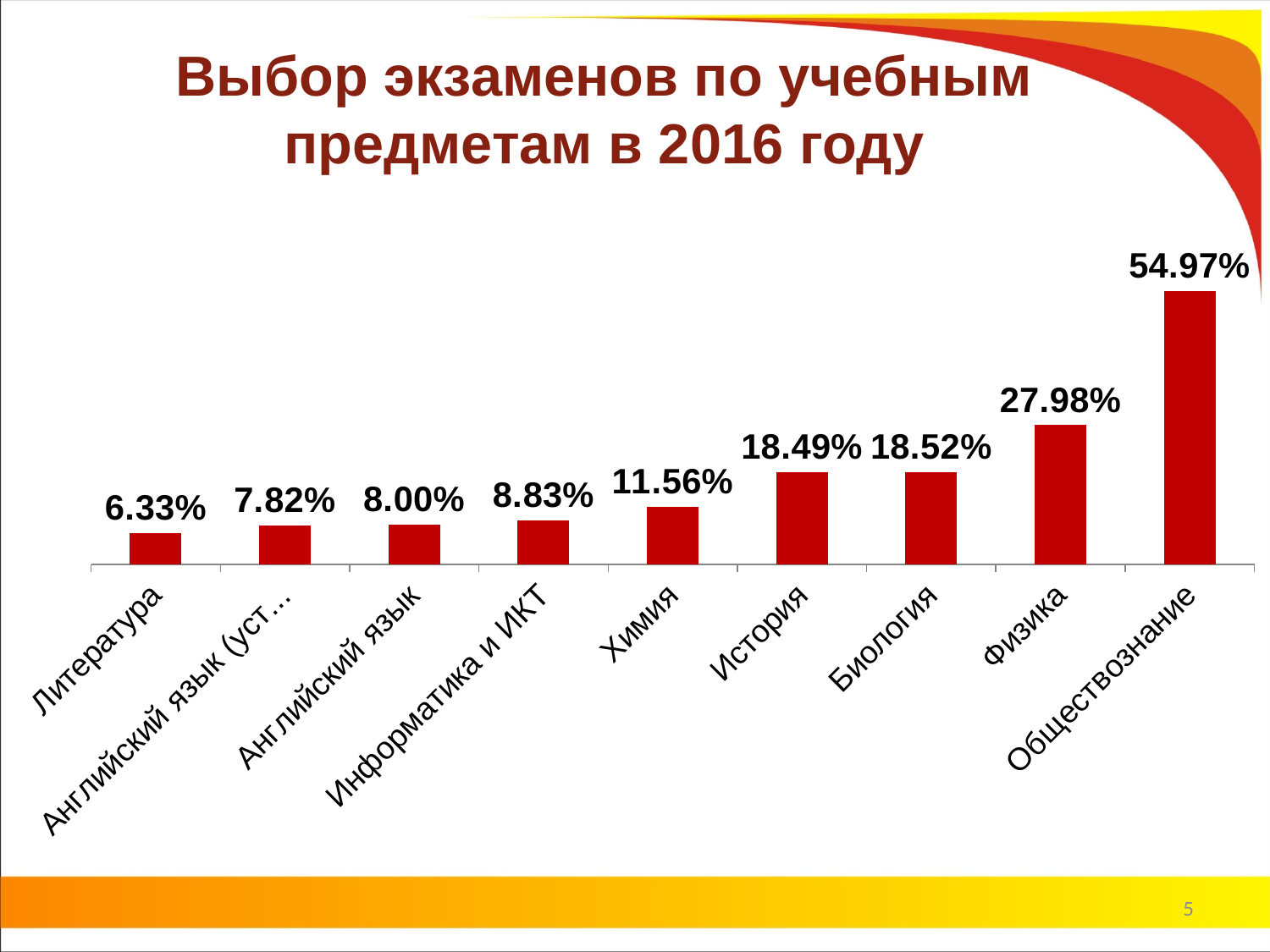
What is the value for Химия? 11.56% What is the value for Литература? 6.33% Which subject has the highest value? Обществознание How many subjects are shown in the chart? 9 What is the value for Обществознание? 54.97% What is the difference between the values for Обществознание and Физика? 26.99% What is the value for Информатика и ИКТ? 8.83% Which is larger, the value for Физика or the value for Химия? Физика Which subject has the lowest value? Литература Do the values rise or fall from left to right along the x axis? rise What kind of chart is shown on the slide? bar chart What is the value for Физика? 27.98%